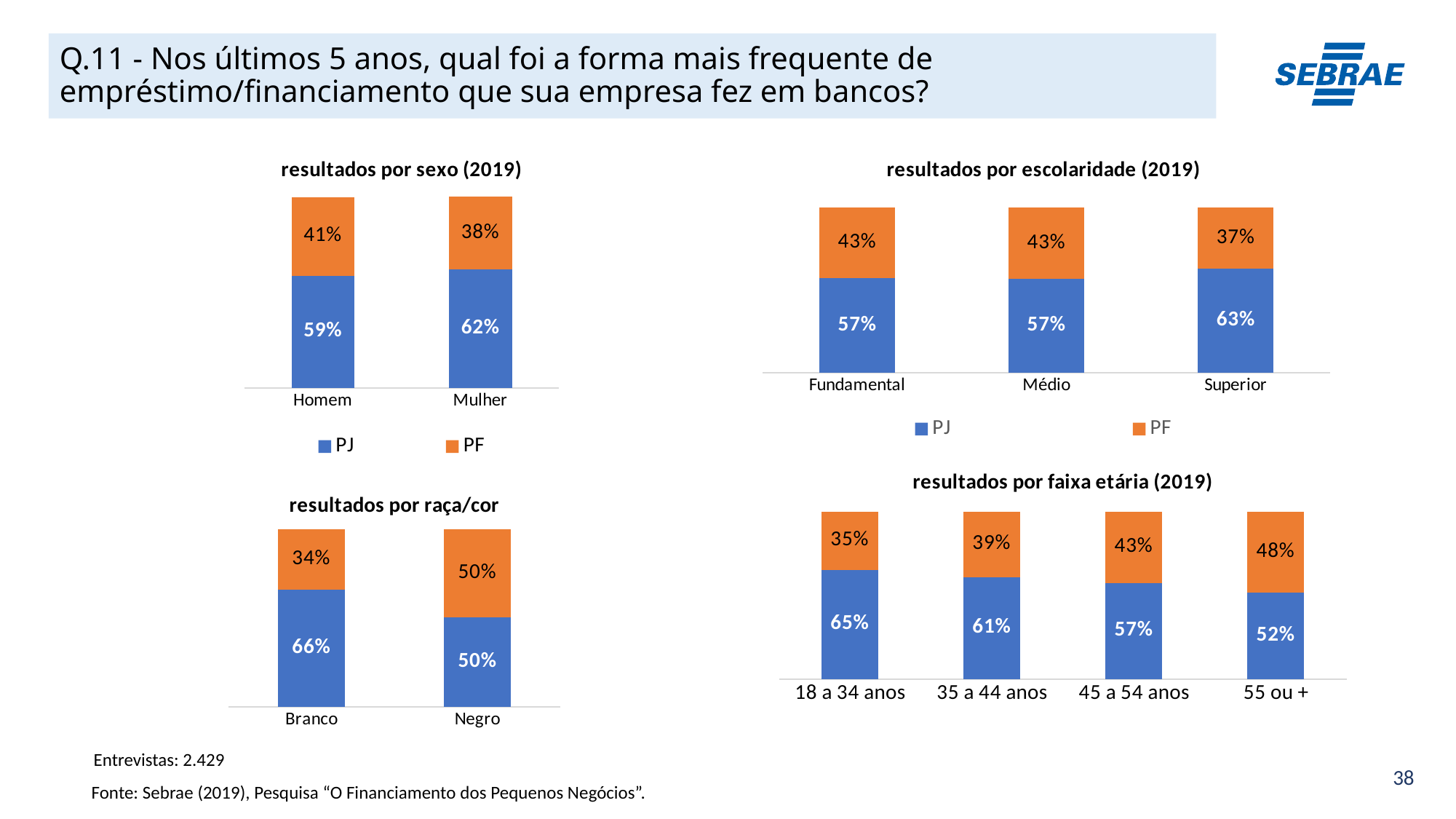
In the 'resultados por sexo (2019)' chart, what is the PF value for Homem? 41% In the 'resultados por sexo (2019)' chart, what is the PJ value for Mulher? 62% In the 'resultados por faixa etária (2019)' chart, what is the PF value for 35 a 44 anos? 39% How many series does the legend of the 'resultados por sexo (2019)' chart list? 2 In the 'resultados por faixa etária (2019)' chart, which age group has the lowest PJ value? 55 ou + In the 'resultados por escolaridade (2019)' chart, what is the PF value for Superior? 37% How many categories are shown in the 'resultados por faixa etária (2019)' chart? 4 In the 'resultados por raça/cor' chart, what is the difference between the PJ values for Branco and Negro? 16% In the 'resultados por raça/cor' chart, what is the PF value for Branco? 34% In the 'resultados por escolaridade (2019)' chart, which category has the highest PJ value? Superior What kind of chart is the 'resultados por escolaridade (2019)' chart? stacked bar chart In the 'resultados por faixa etária (2019)' chart, does the PJ value rise or fall as age increases from 18 a 34 anos to 55 ou +? fall